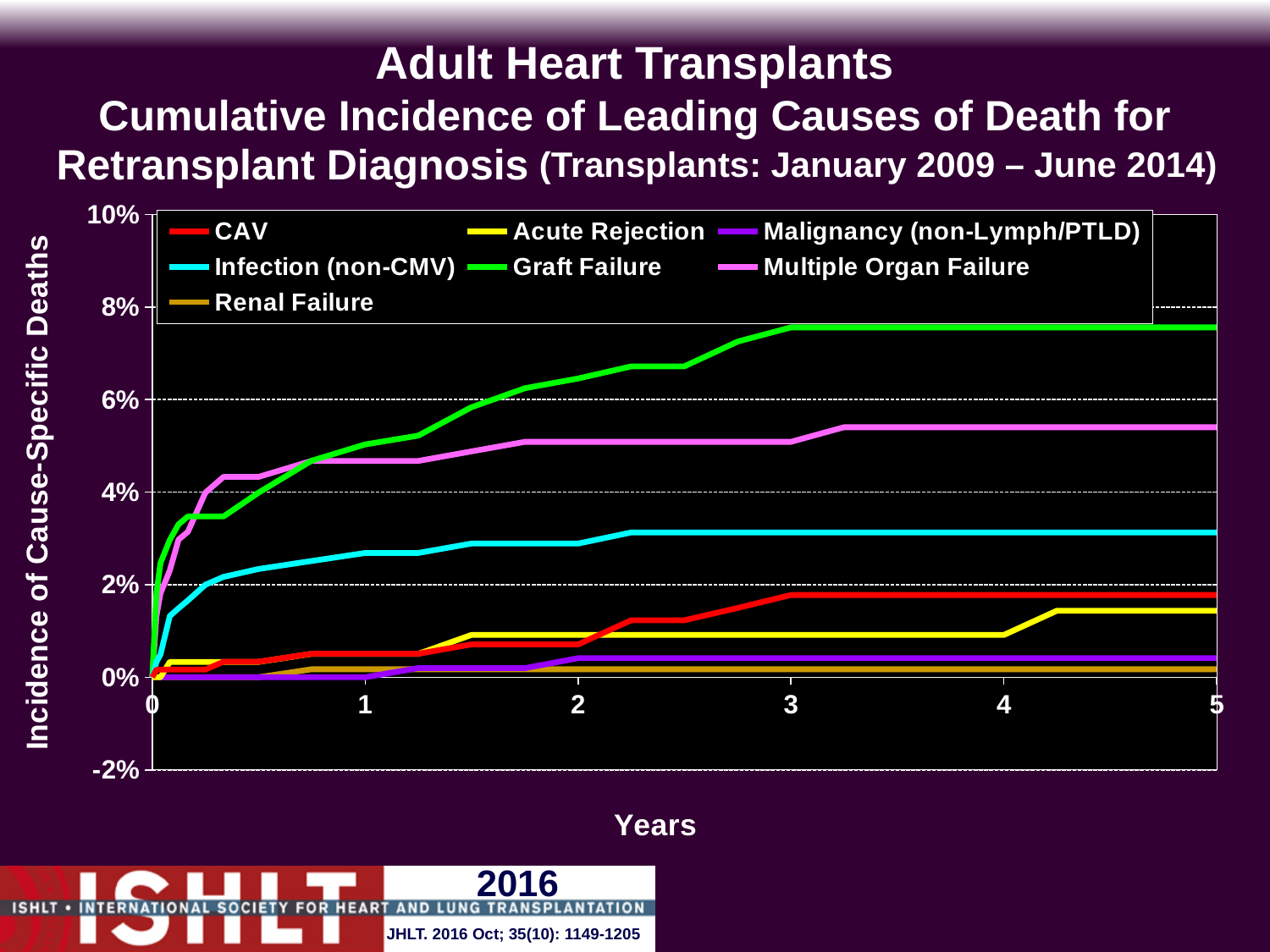
What kind of chart is shown on the slide? line chart What is the label of the y axis? Incidence of Cause-Specific Deaths Is the value for Malignancy (non-Lymph/PTLD) at 5 years greater or less than 2%? less Is the value for Multiple Organ Failure at 5 years greater or less than 4%? greater At 5 years, which is larger: Infection (non-CMV) or CAV? Infection (non-CMV) Is the value for Graft Failure at 5 years greater or less than 6%? greater How many series does the legend list? 7 Which cause of death has the highest cumulative incidence at 5 years? Graft Failure Which cause of death has the lowest cumulative incidence at 5 years? Renal Failure Does the Graft Failure line rise or fall as years increase? rise At 5 years, which is larger: Graft Failure or Multiple Organ Failure? Graft Failure